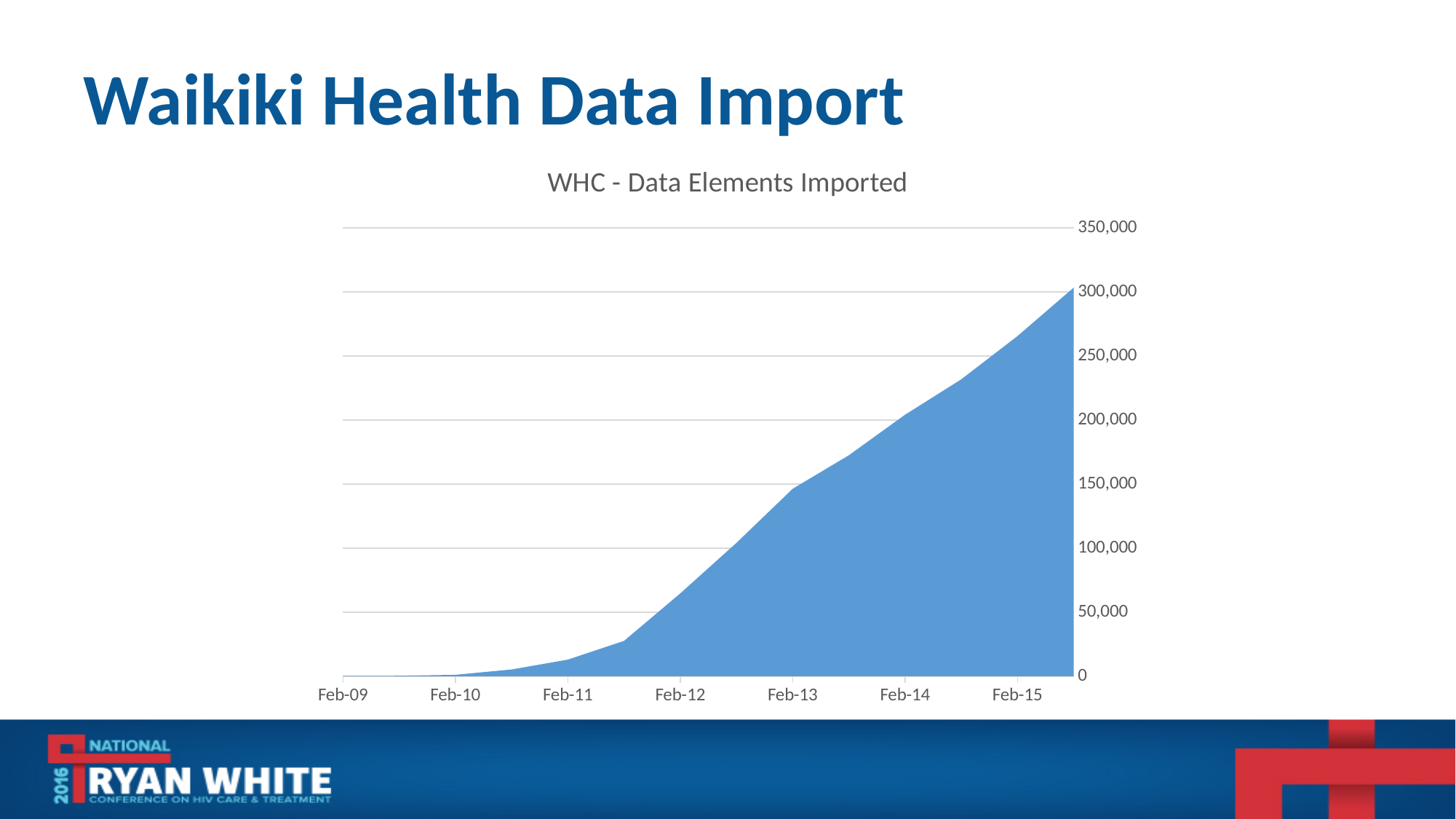
Which labelled date has the highest value? Feb-15 Is the value for Feb-11 greater or less than 50,000? less Do the values rise or fall from Feb-09 to Feb-15? Rise Which labelled date has the lowest value? Feb-09 Is the value for Feb-15 greater or less than 250,000? greater Is the value for Feb-13 greater or less than 100,000? greater Which is larger, the value for Feb-13 or the value for Feb-12? Feb-13 What is the title of the chart? WHC - Data Elements Imported What kind of chart is shown on the slide? Area chart What is the highest value shown on the y axis? 350,000 How many labelled points are on the x axis? 7